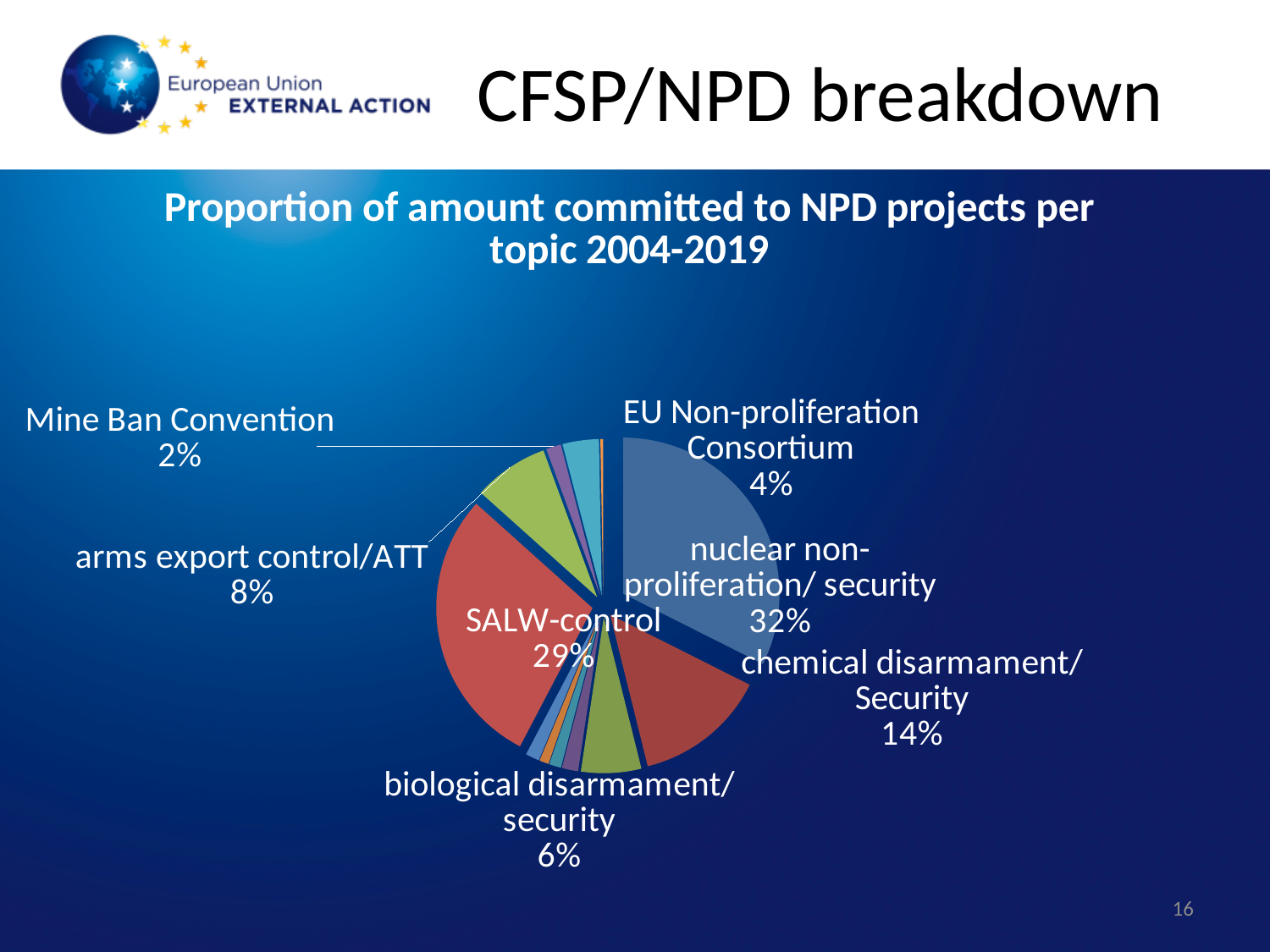
What share of the pie is nuclear non-proliferation/ security? 32% What share of the pie is arms export control/ATT? 8% What is the title of the chart? Proportion of amount committed to NPD projects per topic 2004-2019 Which topic has the largest share of the pie? nuclear non-proliferation/ security Which is larger, the share for chemical disarmament/ Security or for biological disarmament/ security? chemical disarmament/ Security What share of the pie is the Mine Ban Convention? 2% How many percentage points larger is the nuclear non-proliferation/ security share than the SALW-control share? 3 What kind of chart is shown on the slide? pie chart